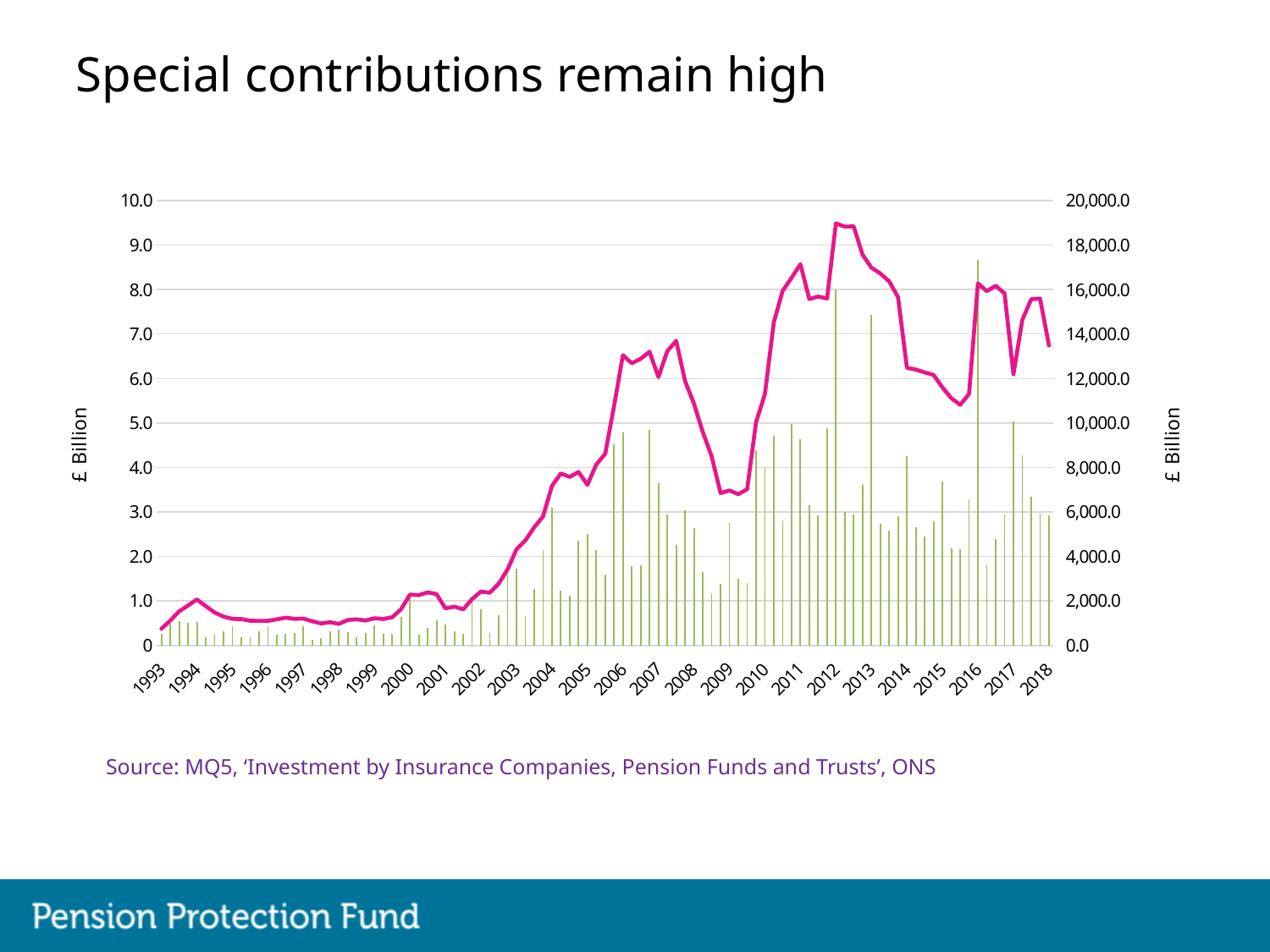
What is the first year shown on the x axis of the chart? 1993 What is the label on the left vertical axis of the chart? £ Billion In which year does the pink line reach its highest point? 2012 Does the pink line generally rise or fall between 1993 and 2018? rise What is the last year shown on the x axis of the chart? 2018 In which year is the tallest green bar? 2016 What kind of chart is shown on the slide? A combined bar and line chart Is the peak value of the pink line in 2012 greater or less than 9.0 on the left axis? greater Is the value of the pink line at the start of 1993 greater or less than 1.0 on the left axis? less How many year labels are shown along the x axis of the chart? 26 What is the title of the chart on the slide? Special contributions remain high Is the tallest green bar in 2016 greater or less than 16,000.0 on the right axis? greater